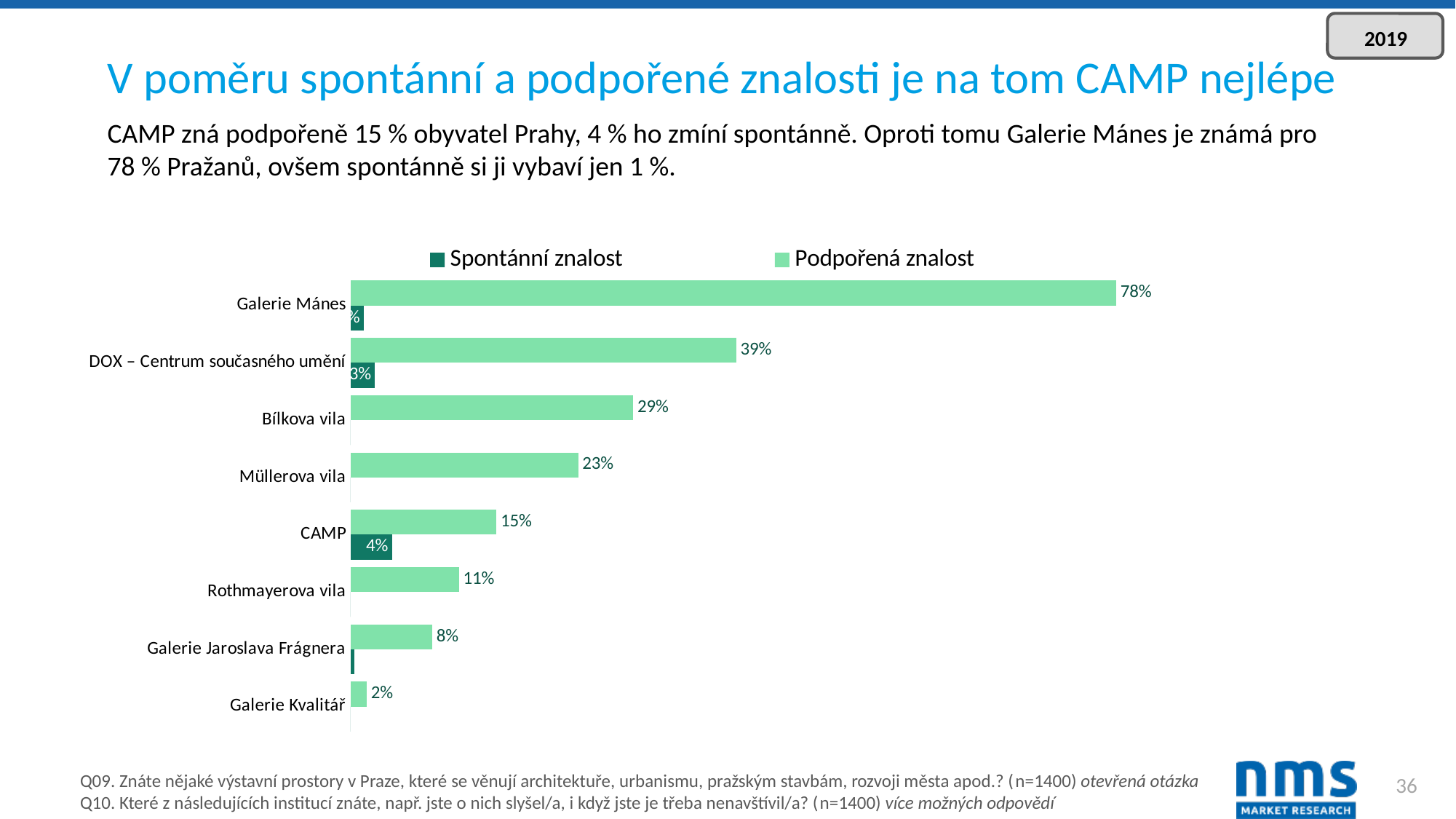
What is the Podpořená znalost value for DOX – Centrum současného umění? 39% What kind of chart is shown on the slide? Bar chart How many series does the legend list? 2 What is the Podpořená znalost value for Rothmayerova vila? 11% Which category has the lowest Podpořená znalost value? Galerie Kvalitář What is the difference between the Podpořená znalost values for Bílkova vila and Müllerova vila? 6% What is the Spontánní znalost value for CAMP? 4% Which category has the highest Podpořená znalost value? Galerie Mánes How many categories are shown on the chart? 8 What is the difference between the Podpořená znalost and Spontánní znalost values for CAMP? 11% What is the Podpořená znalost value for Galerie Mánes? 78% Which has a larger Spontánní znalost value, CAMP or DOX – Centrum současného umění? CAMP